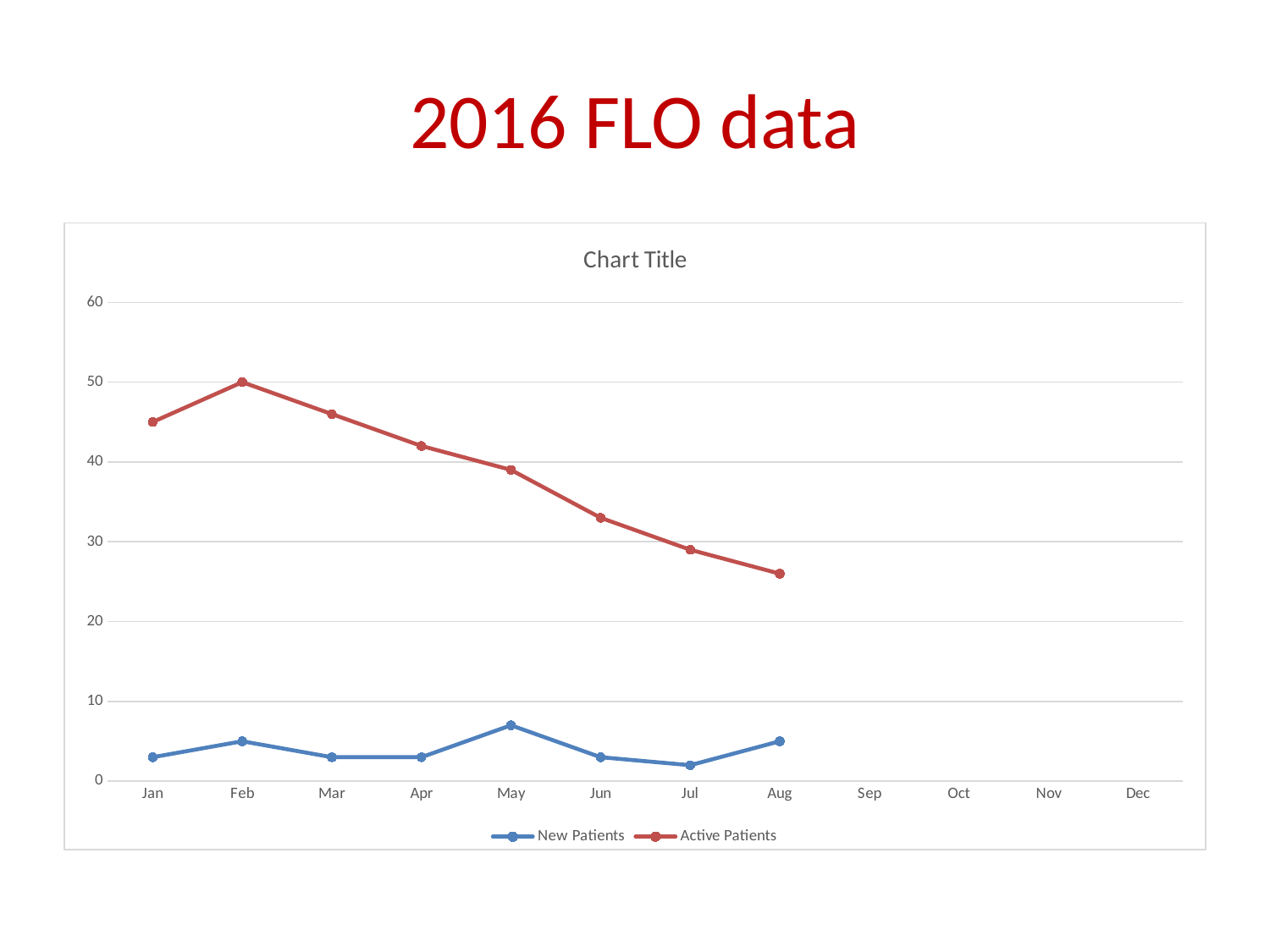
What kind of chart is shown on the slide? line chart Do the Active Patients values rise or fall from Feb to Aug? fall What is the value for Active Patients in Feb? 50 How many series does the legend list? 2 In which month is the Active Patients value lowest? Aug Is the value for Active Patients in Jan greater or less than 40? greater In which month is the Active Patients value highest? Feb In which month is the New Patients value highest? May What are the two series named in the legend? New Patients and Active Patients How many months are labelled on the x axis? 12 Is the value for Active Patients in Aug greater or less than 30? less In Jan, which series has the larger value, New Patients or Active Patients? Active Patients